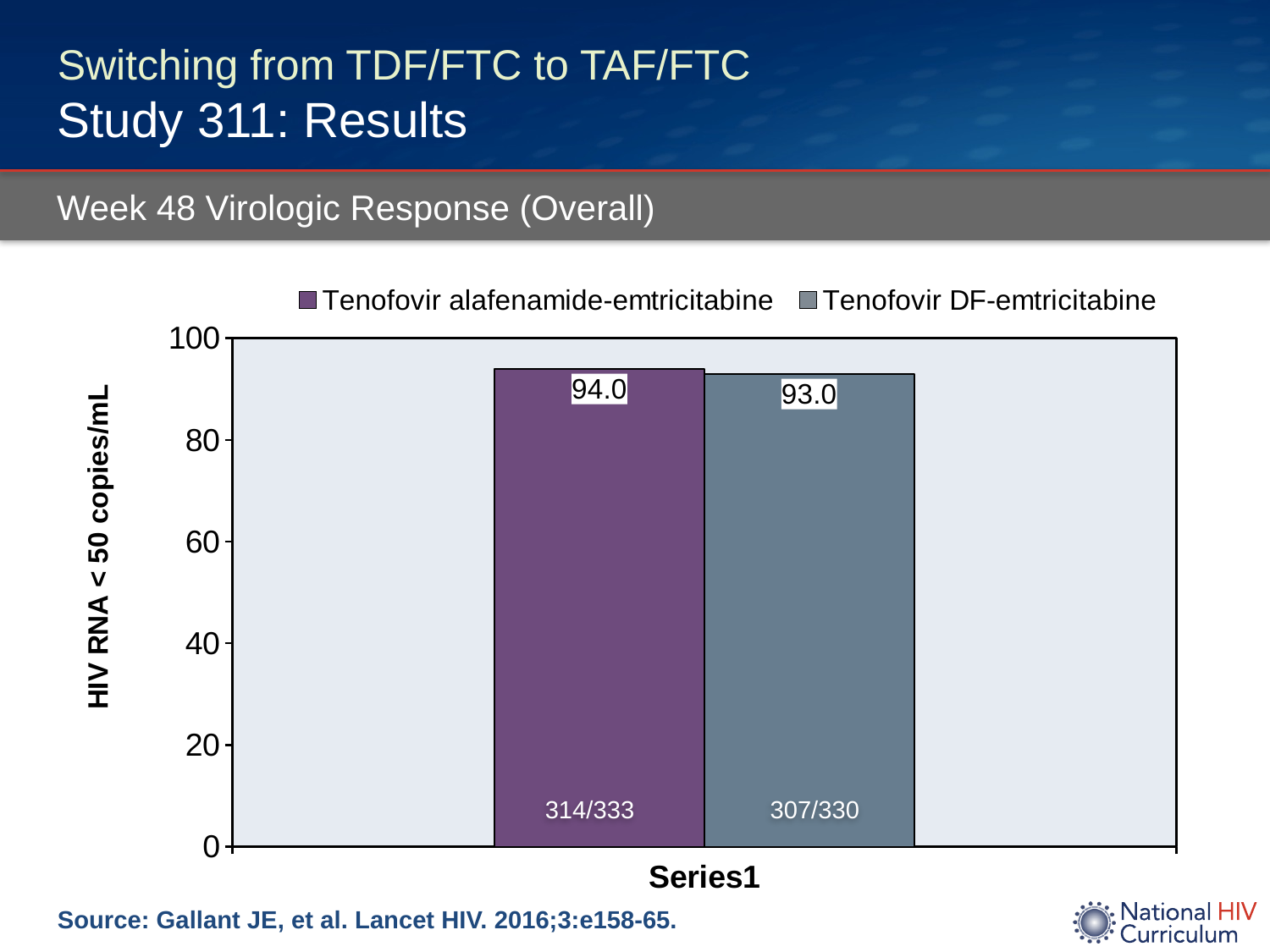
What is the value for Tenofovir alafenamide-emtricitabine? 94.0 What is the value for Tenofovir DF-emtricitabine? 93.0 What is the maximum value shown on the y axis? 100 What kind of chart is shown? Bar chart Which series has the higher value? Tenofovir alafenamide-emtricitabine What is the y-axis label of the chart? HIV RNA < 50 copies/mL How many series does the legend list? 2 Which series has the lower value? Tenofovir DF-emtricitabine What fraction is printed on the Tenofovir alafenamide-emtricitabine bar? 314/333 Is the value for Tenofovir DF-emtricitabine greater or less than 80? greater What fraction is printed on the Tenofovir DF-emtricitabine bar? 307/330 What is the difference between the values for Tenofovir alafenamide-emtricitabine and Tenofovir DF-emtricitabine? 1.0